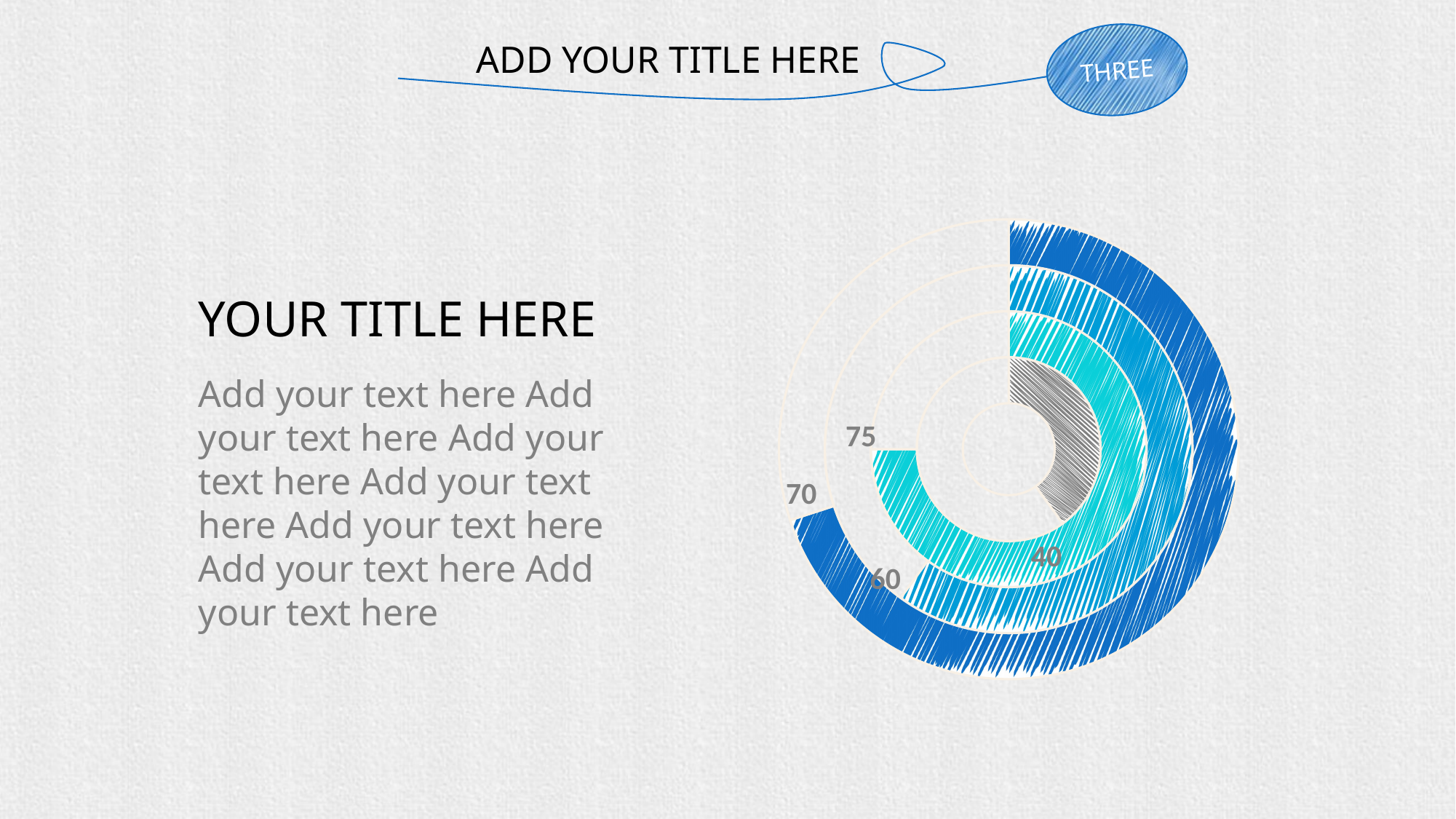
Does the chart have a legend? No What is the lowest value labelled on the chart? 40 What value is labelled on the outermost dark blue ring? 70 What is the highest value labelled on the chart? 75 Which is larger, the value labelled on the outermost dark blue ring or the value labelled on the innermost grey ring? the outermost dark blue ring (70) What is the text in the blue oval at the top right of the slide? THREE What kind of chart is shown on the slide? doughnut chart What value is labelled on the innermost grey ring? 40 How many rings (data series) does the chart show? 4 What is the difference between the highest labelled value (75) and the lowest labelled value (40)? 35 What are all the values labelled on the chart, from smallest to largest? 40, 60, 70, 75 What is the difference between the values labelled 70 and 60? 10